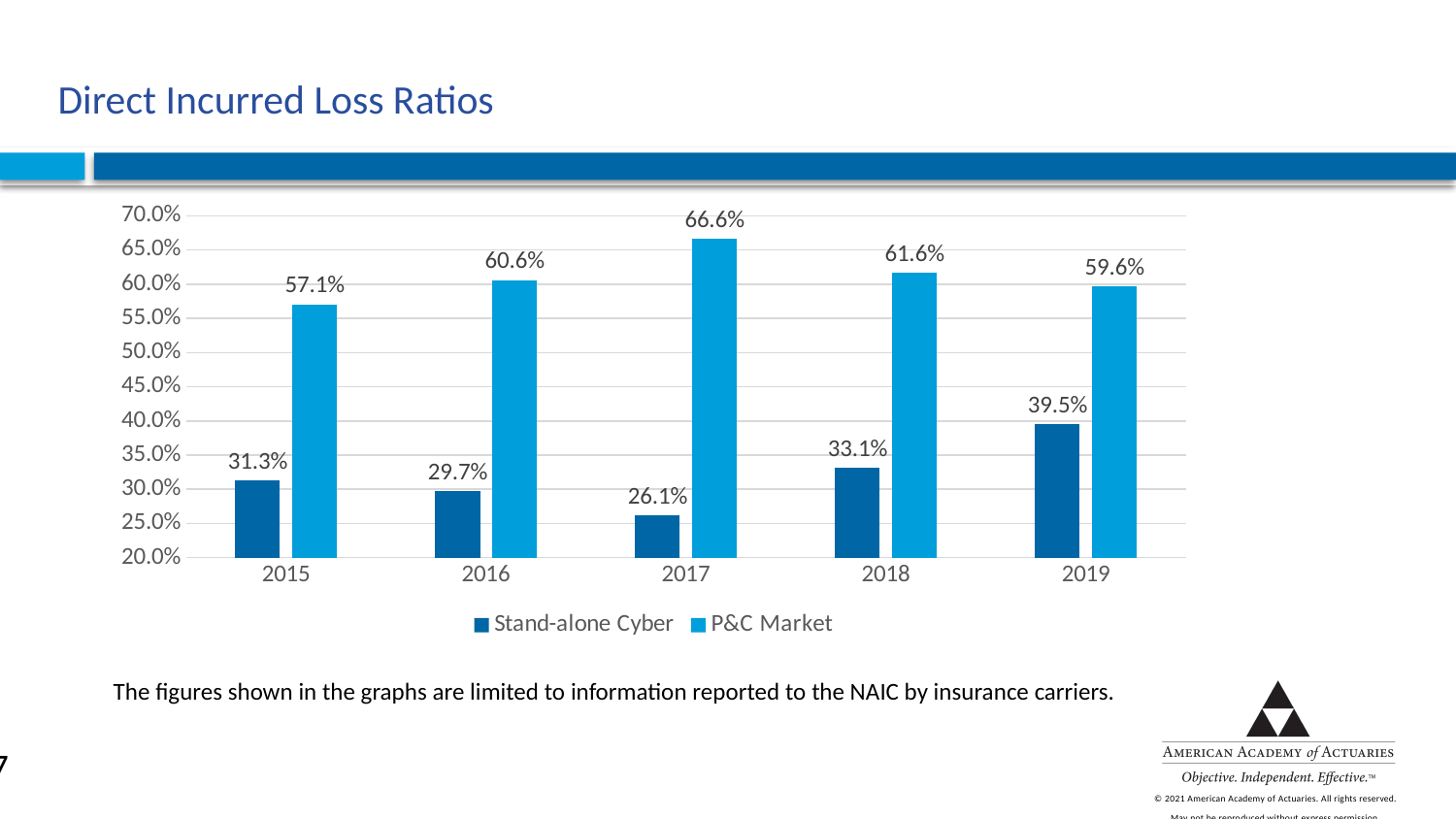
What is the Stand-alone Cyber loss ratio for 2017? 26.1% What kind of chart is shown on the slide? Bar chart Which is larger, the Stand-alone Cyber loss ratio in 2015 or in 2016? 2015 Is the P&C Market loss ratio for 2019 greater or less than 55.0%? greater What is the title of the chart? Direct Incurred Loss Ratios What is the Stand-alone Cyber loss ratio for 2019? 39.5% In which year is the P&C Market loss ratio highest? 2017 How many years are shown on the x axis? 5 What is the difference between the P&C Market and Stand-alone Cyber loss ratios in 2018? 28.5% In which year is the Stand-alone Cyber loss ratio lowest? 2017 What is the P&C Market loss ratio for 2016? 60.6% How many series does the legend list? 2